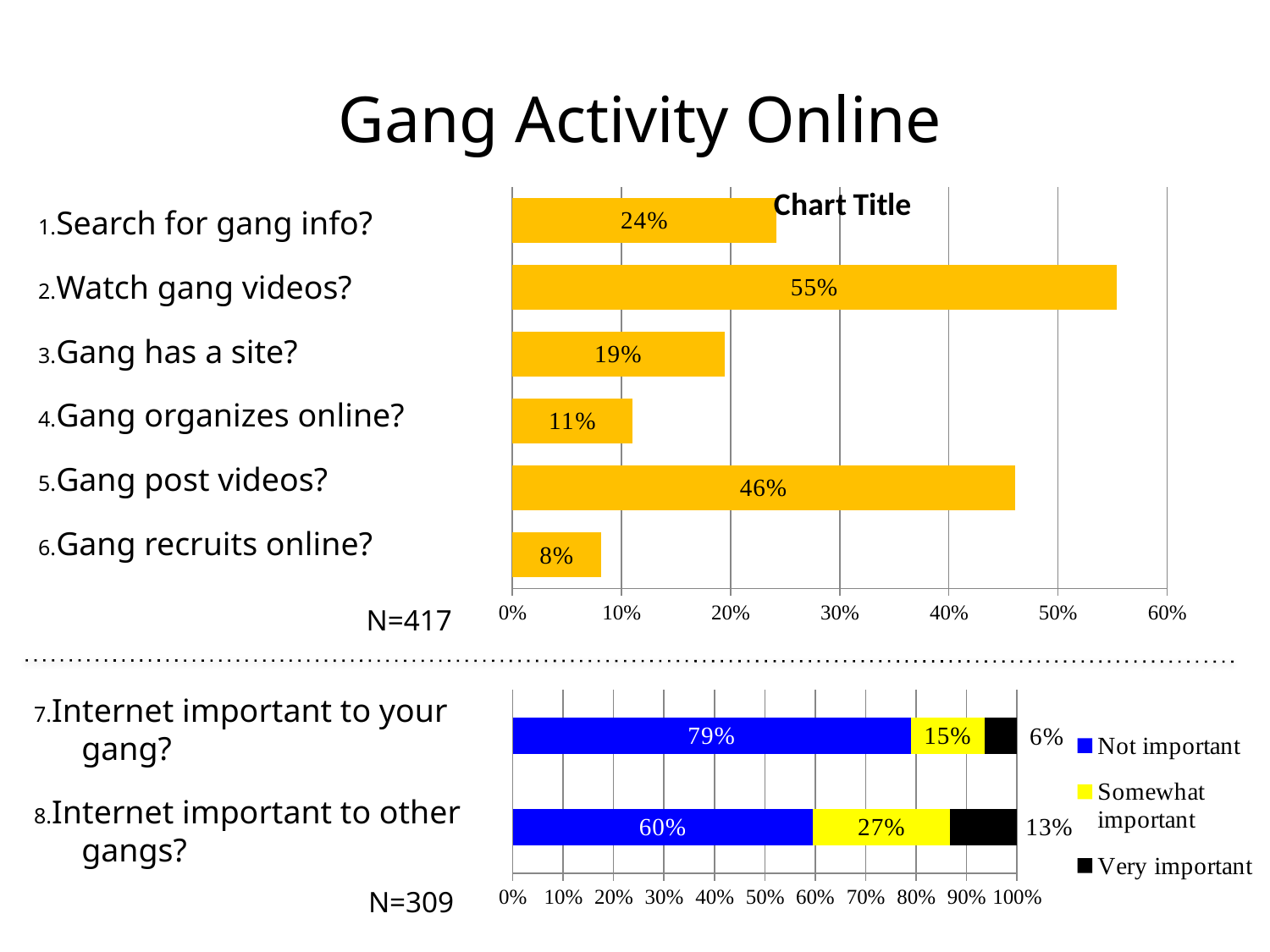
How many bars are plotted in the top chart? 6 In the bottom chart, what colour represents "Somewhat important"? Yellow In the bottom chart, what percentage of respondents said the internet is "Not important" to their own gang? 79% In the bottom chart, what percentage said the internet is "Very important" to other gangs? 13% In the top chart, which item has the lowest percentage? Gang recruits online? In the top chart, what percentage is shown for "Gang recruits online?" 8% In the top chart, which is larger: the value for "Gang has a site?" or the value for "Gang organizes online?" Gang has a site? In the top chart, what is the difference between the percentages for "Gang post videos?" and "Search for gang info?" 22% In the top chart, which item has the highest percentage? Watch gang videos? How many series does the legend of the bottom chart list? 3 What kind of chart is the top chart? Bar chart In the top chart, what percentage is shown for "Watch gang videos?" 55%